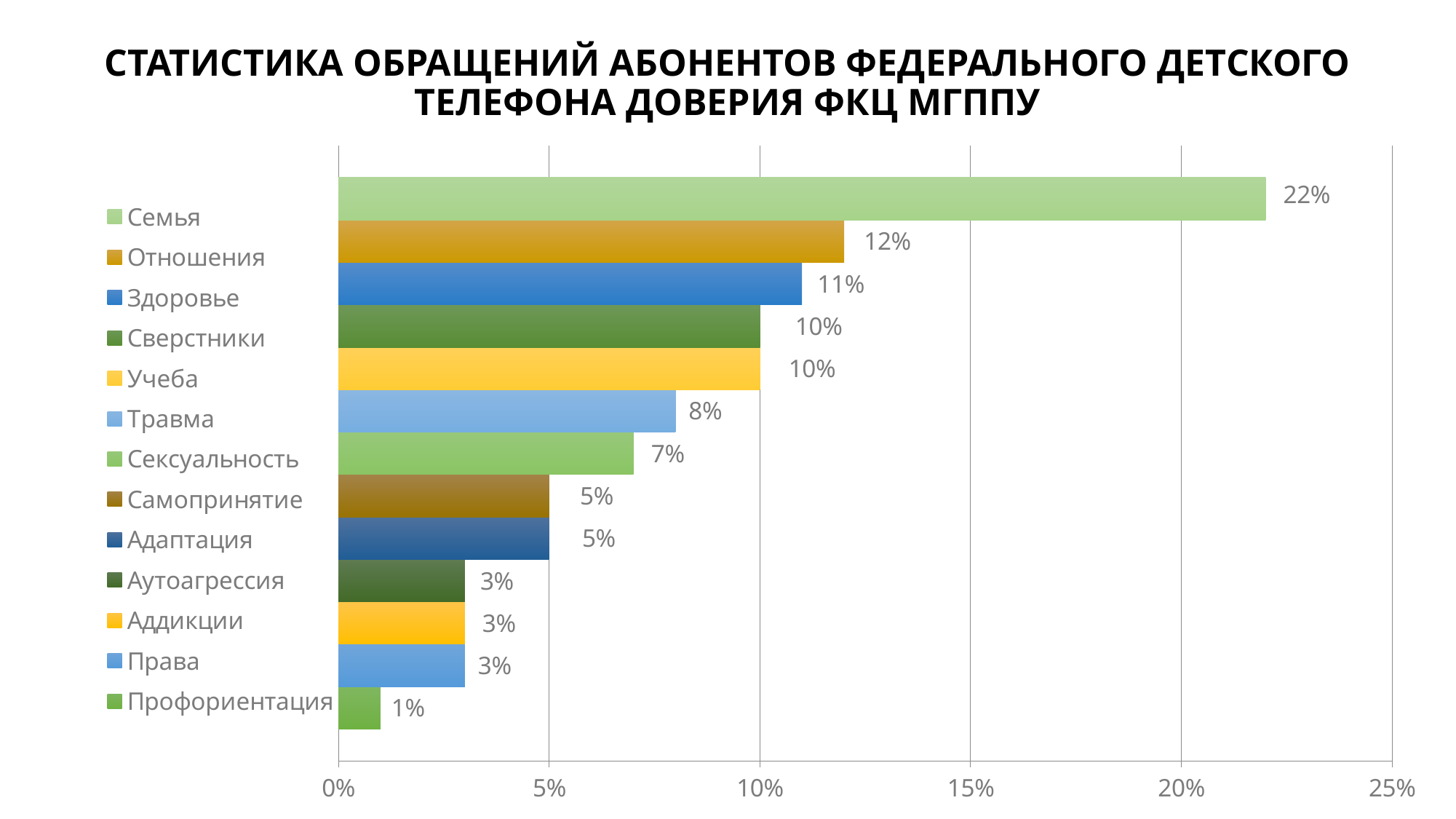
Which category has the lowest value? Профориентация What is the value for Сексуальность? 7% What is the difference between the values for Семья and Отношения? 10% Which is larger, the value for Здоровье or the value for Травма? Здоровье How many categories are shown in the chart? 13 What kind of chart is shown on the slide? bar chart Is the value for Отношения greater or less than 10%? greater Which category has the highest value? Семья What is the value for Травма? 8% What is the value for Самопринятие? 5% What is the maximum value shown on the horizontal axis? 25% What is the value for Семья? 22%